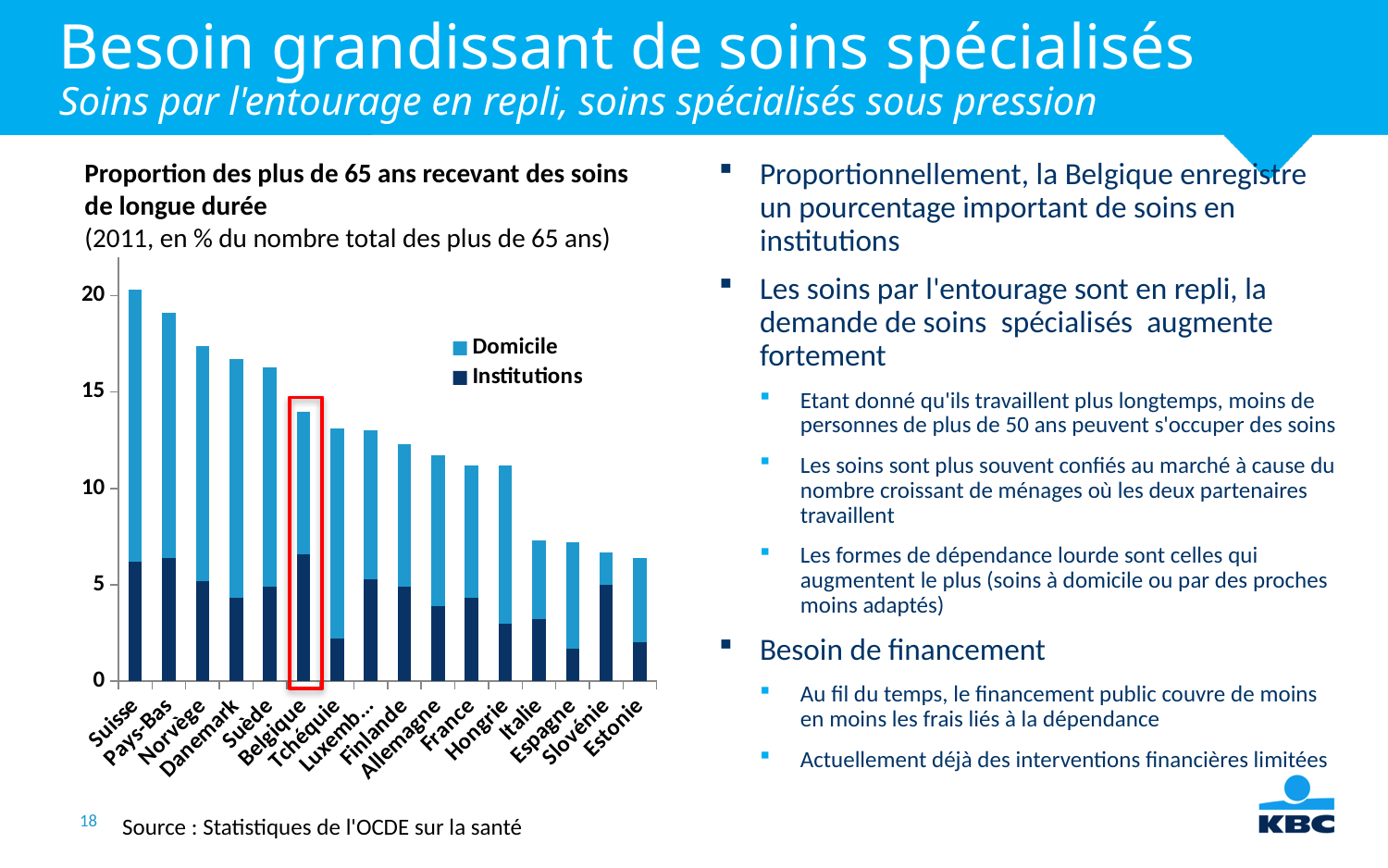
Is the total value for Estonie greater or less than 10? less How many countries are shown on the x axis of the chart? 16 Which country has the lowest Institutions value in the chart? Espagne Which country's bar is highlighted with a red box in the chart? Belgique Do the total bar values rise or fall from left to right along the x axis? fall Which has a larger total bar, Norvège or Italie? Norvège How many series does the chart legend list? 2 What kind of chart is shown on the slide? stacked bar chart Is the total value for Belgique greater or less than 15? less Is the total value for Pays-Bas greater or less than 15? greater Which country has the highest total bar in the chart? Suisse Which has a larger Institutions value, Belgique or Espagne? Belgique